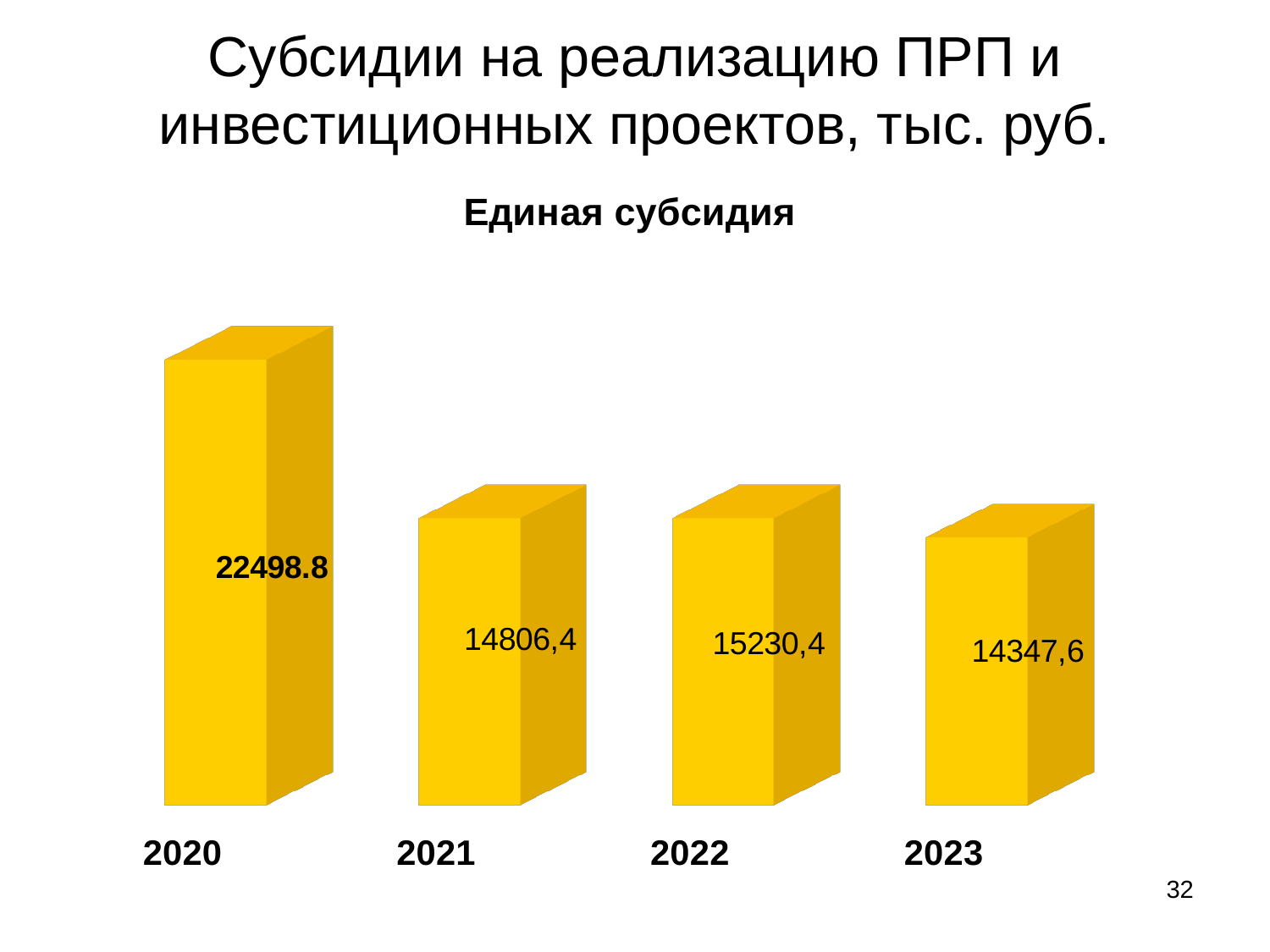
Which is larger, the value for 2021 or the value for 2022? 2022 Which year has the lowest value? 2023 What is the value for 2021? 14806,4 What is the value for 2022? 15230,4 What is the difference between the values for 2022 and 2023? 882,8 What kind of chart is shown on the slide? bar chart What is the title of the chart? Единая субсидия What is the difference between the values for 2022 and 2021? 424,0 What is the value for 2023? 14347,6 What is the value for 2020? 22498.8 Which year has the highest value? 2020 How many years are shown on the chart? 4